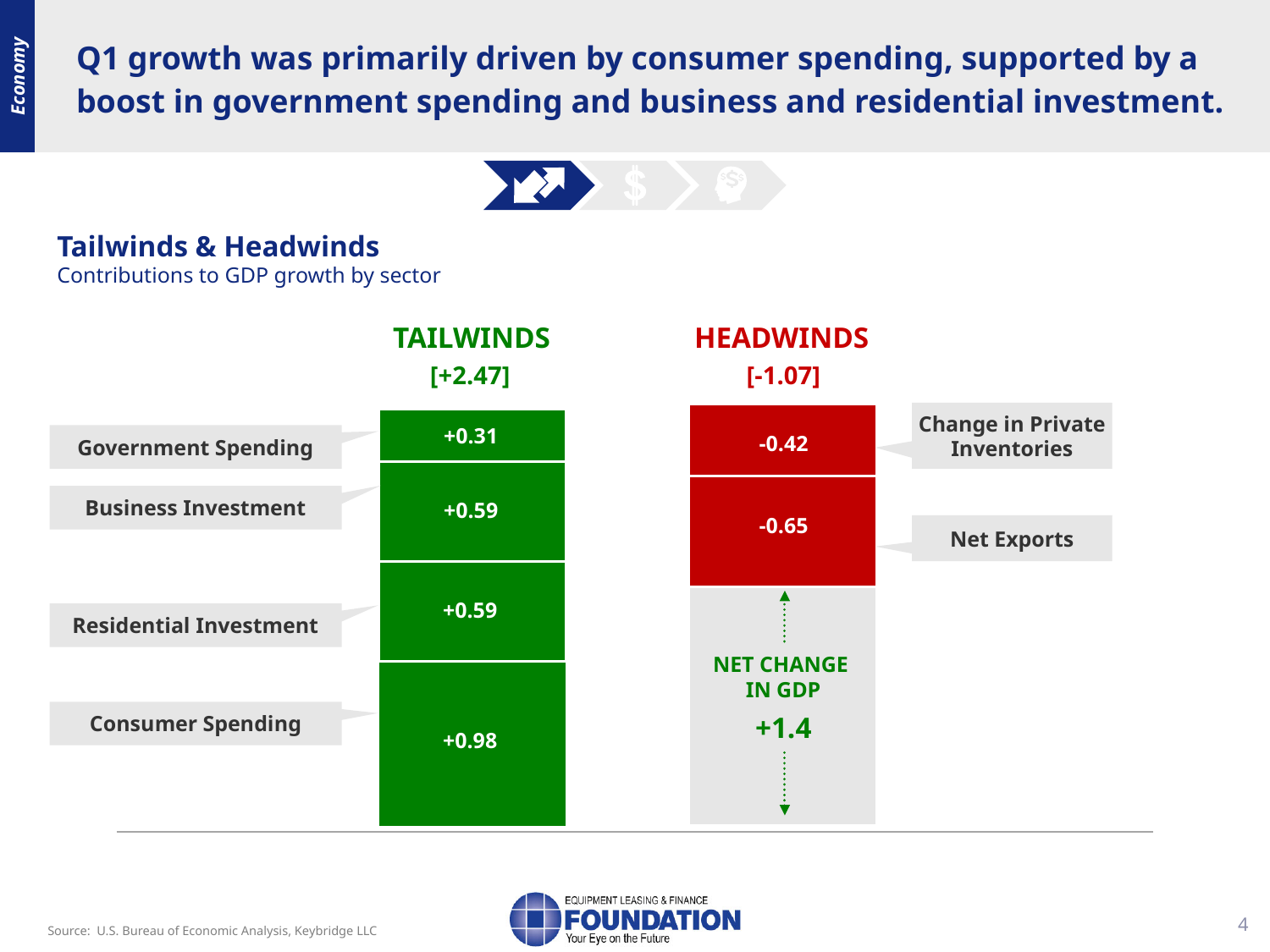
What is the contribution of Government Spending to GDP growth? +0.31 What is the total of the Headwinds bar? -1.07 What is the contribution of Consumer Spending to GDP growth? +0.98 Which tailwind sector has the smallest contribution to GDP growth? Government Spending What is the difference between the Consumer Spending and Government Spending contributions? 0.67 What is the contribution of Change in Private Inventories to GDP growth? -0.42 What is the total of the Tailwinds bar? +2.47 What is the net change in GDP shown on the chart? +1.4 Which tailwind sector has the largest contribution to GDP growth? Consumer Spending What is the contribution of Net Exports to GDP growth? -0.65 Which headwind is larger in magnitude, Net Exports or Change in Private Inventories? Net Exports How many sectors are shown as tailwinds? 4